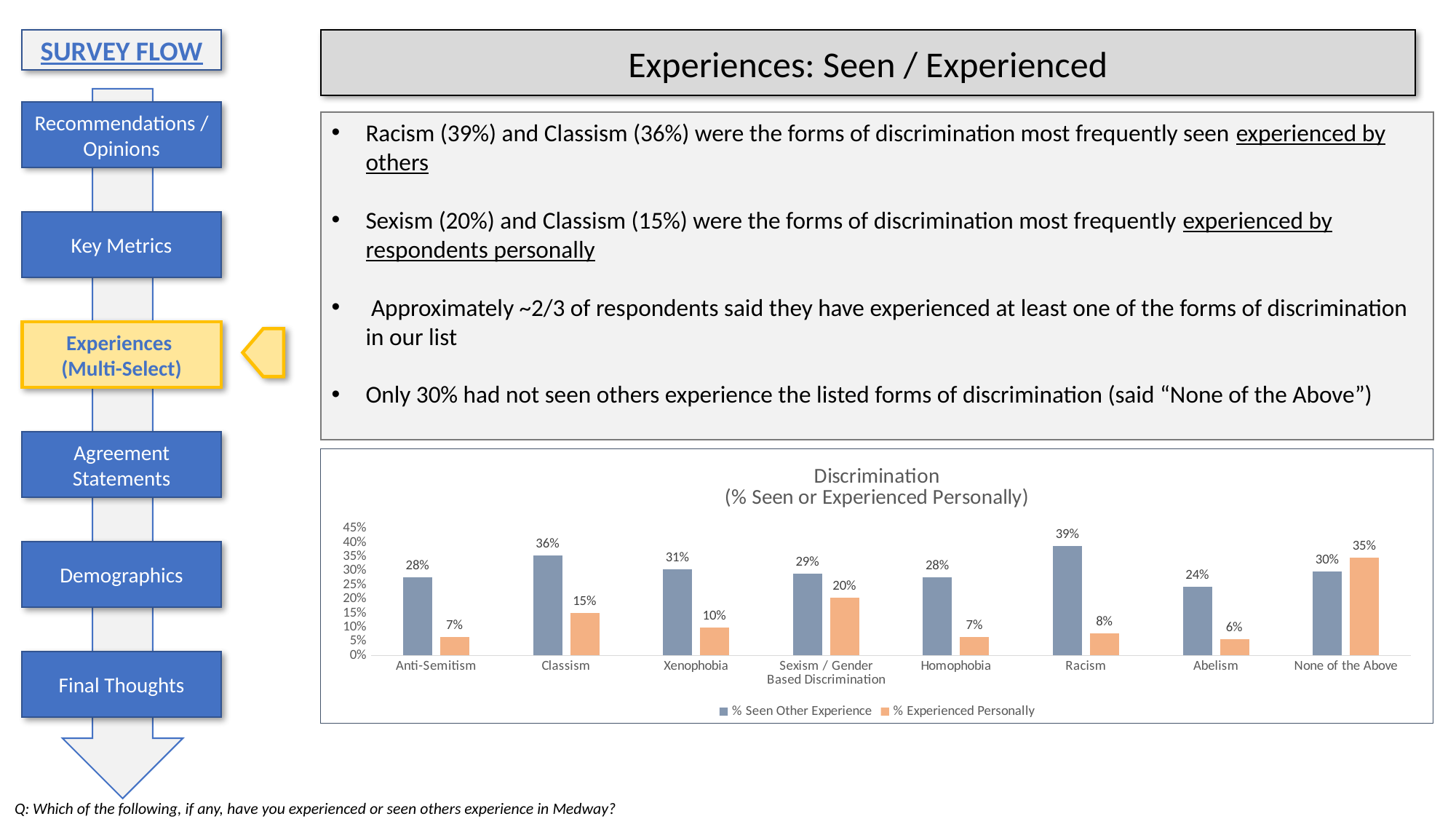
What kind of chart is shown on the slide? Bar chart What is the value of % Experienced Personally for Sexism / Gender Based Discrimination? 20% Which series is shown in orange in the chart? % Experienced Personally What is the difference between % Seen Other Experience and % Experienced Personally for Classism? 21% What is the title of the chart? Discrimination (% Seen or Experienced Personally) Which is larger for None of the Above: % Seen Other Experience or % Experienced Personally? % Experienced Personally Which category has the lowest value for % Experienced Personally? Abelism What is the value of % Seen Other Experience for Racism? 39% What is the value of % Experienced Personally for Abelism? 6% How many series does the legend list? 2 Which category has the highest value for % Seen Other Experience? Racism How many categories are shown on the x axis of the chart? 8